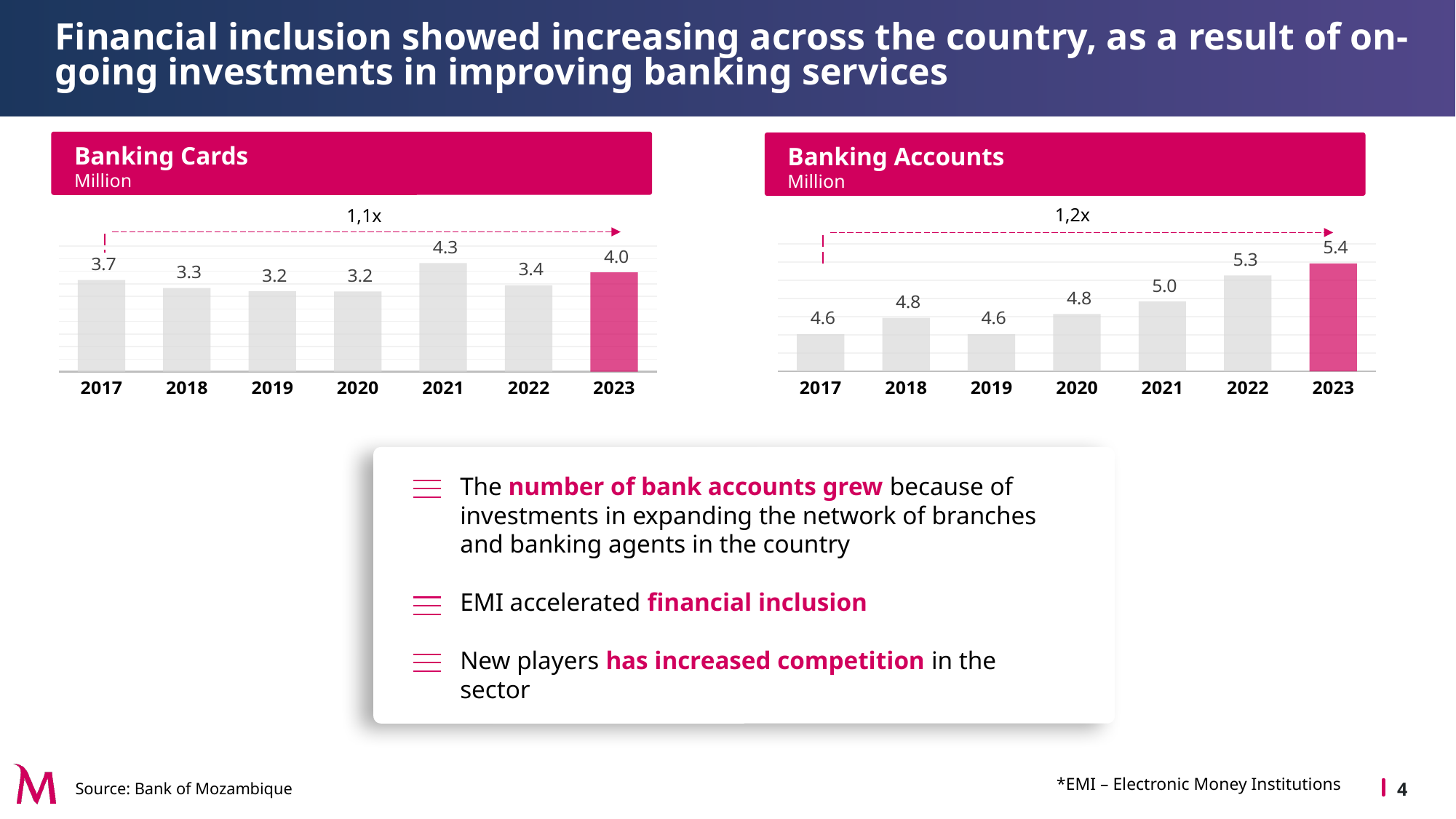
In the Banking Cards chart, which is larger, the value for 2017 or the value for 2022? 2017 What kind of chart is the Banking Accounts chart? Bar chart In the Banking Accounts chart, what is the difference between the 2023 value and the 2017 value? 0.8 In the Banking Accounts chart, which year has the highest value? 2023 In the Banking Accounts chart, do the values generally rise or fall from 2019 to 2023? Rise In the Banking Cards chart, which year has the highest value? 2021 How many years are shown in the Banking Cards chart? 7 In the Banking Cards chart, what is the difference between the 2021 value and the 2020 value? 1.1 In the Banking Accounts chart, which is larger, the value for 2018 or the value for 2021? 2021 What unit is stated under the title of the Banking Cards chart? Million In the Banking Accounts chart, what is the value for 2023? 5.4 In the Banking Cards chart, what is the value for 2021? 4.3